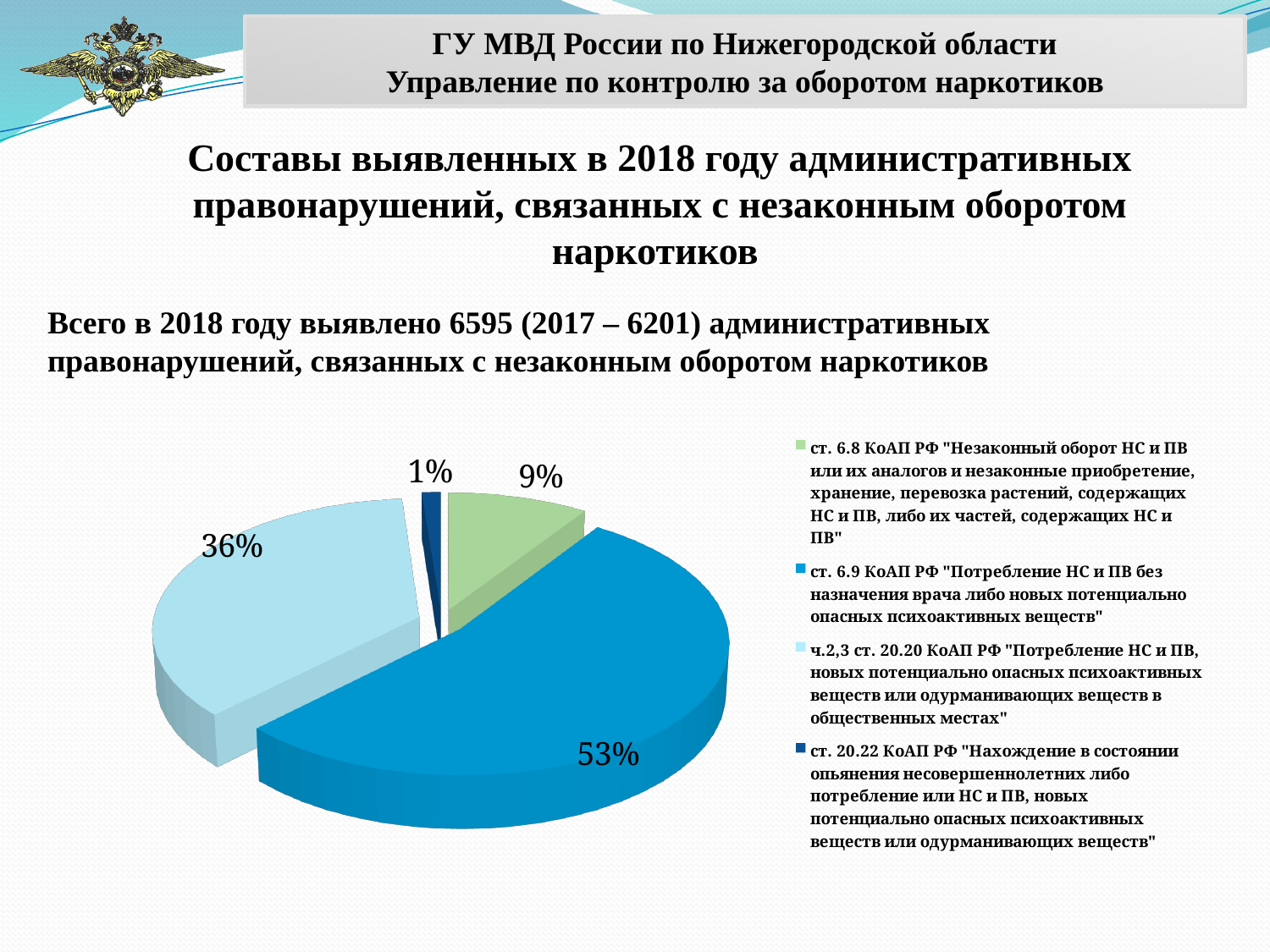
Which category has the largest slice of the pie? ст. 6.9 КоАП РФ What is the difference in percentage points between the slices for ст. 6.9 КоАП РФ and ч.2,3 ст. 20.20 КоАП РФ? 17 What colour is the slice representing ст. 6.8 КоАП РФ? green Which category has the smallest slice of the pie? ст. 20.22 КоАП РФ Which slice is larger: ст. 6.8 КоАП РФ or ч.2,3 ст. 20.20 КоАП РФ? ч.2,3 ст. 20.20 КоАП РФ What share of the pie does ст. 6.8 КоАП РФ account for? 9% What share of the pie does ст. 20.22 КоАП РФ account for? 1% What share of the pie does ч.2,3 ст. 20.20 КоАП РФ account for? 36% How many entries does the legend of the pie chart list? 4 What kind of chart is shown on the slide? pie chart How many slices does the pie chart have? 4